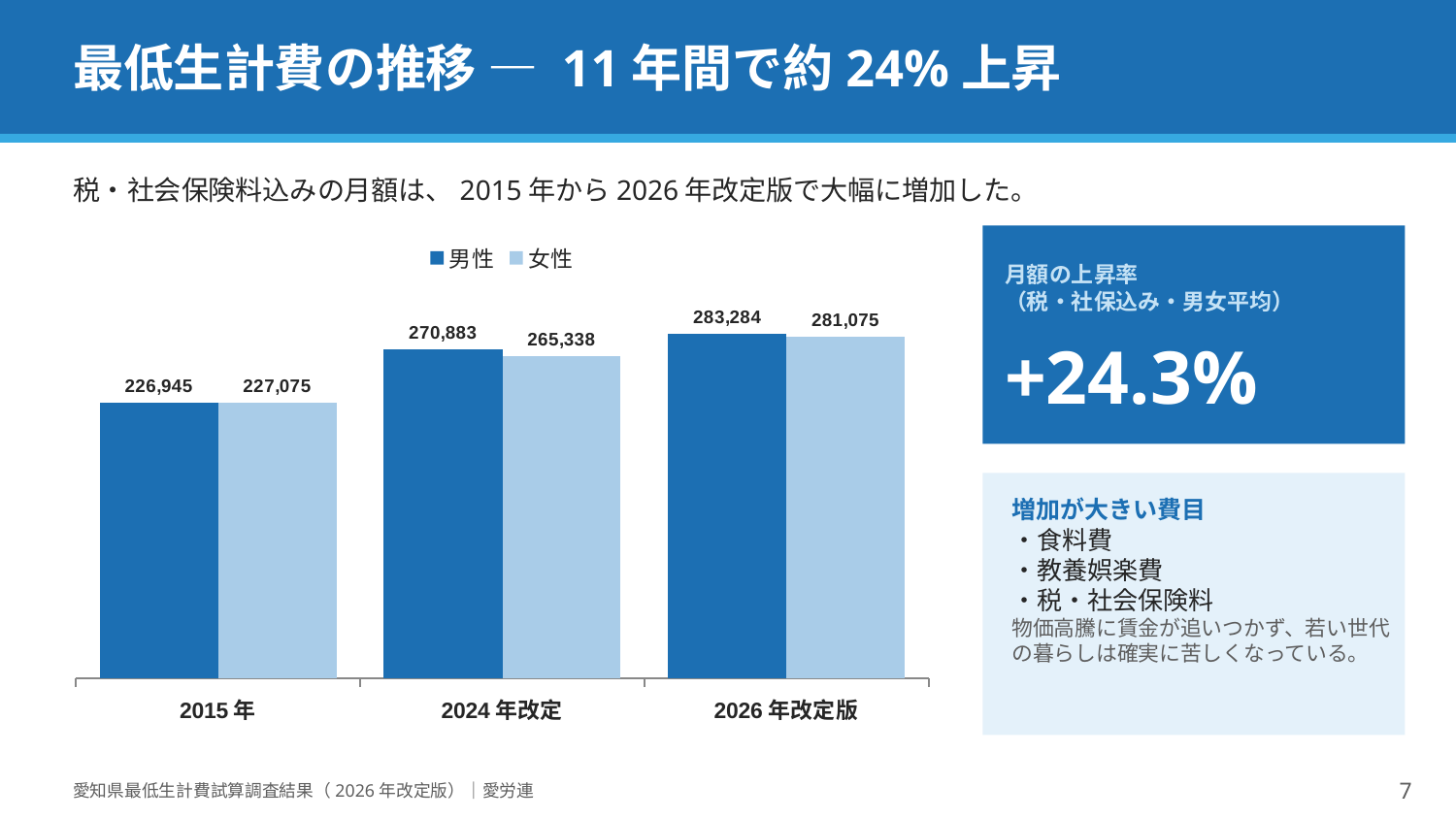
What is the value for 男性 in 2026年改定版? 283,284 What is the value for 女性 in 2024年改定? 265,338 In 2024年改定, which is larger, the 男性 value or the 女性 value? 男性 How many series does the legend list? 2 What is the difference between the 男性 and 女性 values in 2024年改定? 5,545 What is the difference between the 男性 values for 2026年改定版 and 2015年? 56,339 What is the value for 女性 in 2026年改定版? 281,075 Which category has the highest value for 男性? 2026年改定版 Do the 女性 values rise or fall from 2015年 to 2026年改定版? rise Which category has the lowest value for 女性? 2015年 What is the value for 男性 in 2015年? 226,945 How many categories are shown on the x axis? 3